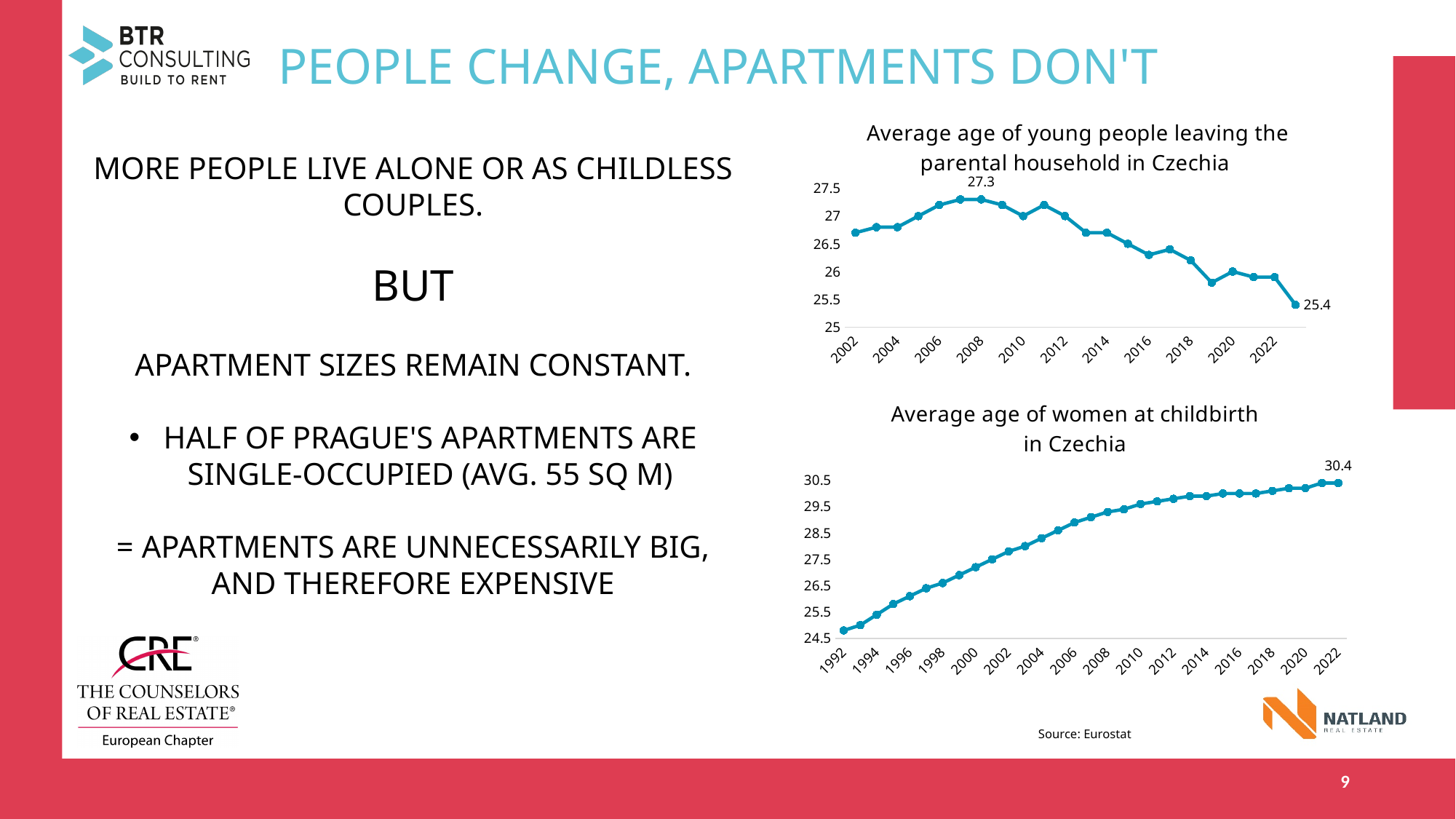
What kind of chart is the 'Average age of young people leaving the parental household in Czechia' chart? line chart In the 'Average age of young people leaving the parental household in Czechia' chart, what is the value for 2008? 27.3 In the 'Average age of women at childbirth in Czechia' chart, which year has the higher value, 1992 or 2022? 2022 In the 'Average age of young people leaving the parental household in Czechia' chart, is the value for 2002 greater or less than 27? less In the 'Average age of women at childbirth in Czechia' chart, is the value for 1992 greater or less than 25.5? less In the 'Average age of young people leaving the parental household in Czechia' chart, do the values overall rise or fall from 2008 to the end of the series? fall In the 'Average age of women at childbirth in Czechia' chart, what is the value for 2022? 30.4 In the 'Average age of young people leaving the parental household in Czechia' chart, what is the lowest value shown? 25.4 What source is cited for the charts on the slide? Eurostat In the 'Average age of young people leaving the parental household in Czechia' chart, what is the difference between the labelled peak value and the labelled final value? 1.9 In the 'Average age of women at childbirth in Czechia' chart, do the values rise or fall from 1992 to 2022? rise